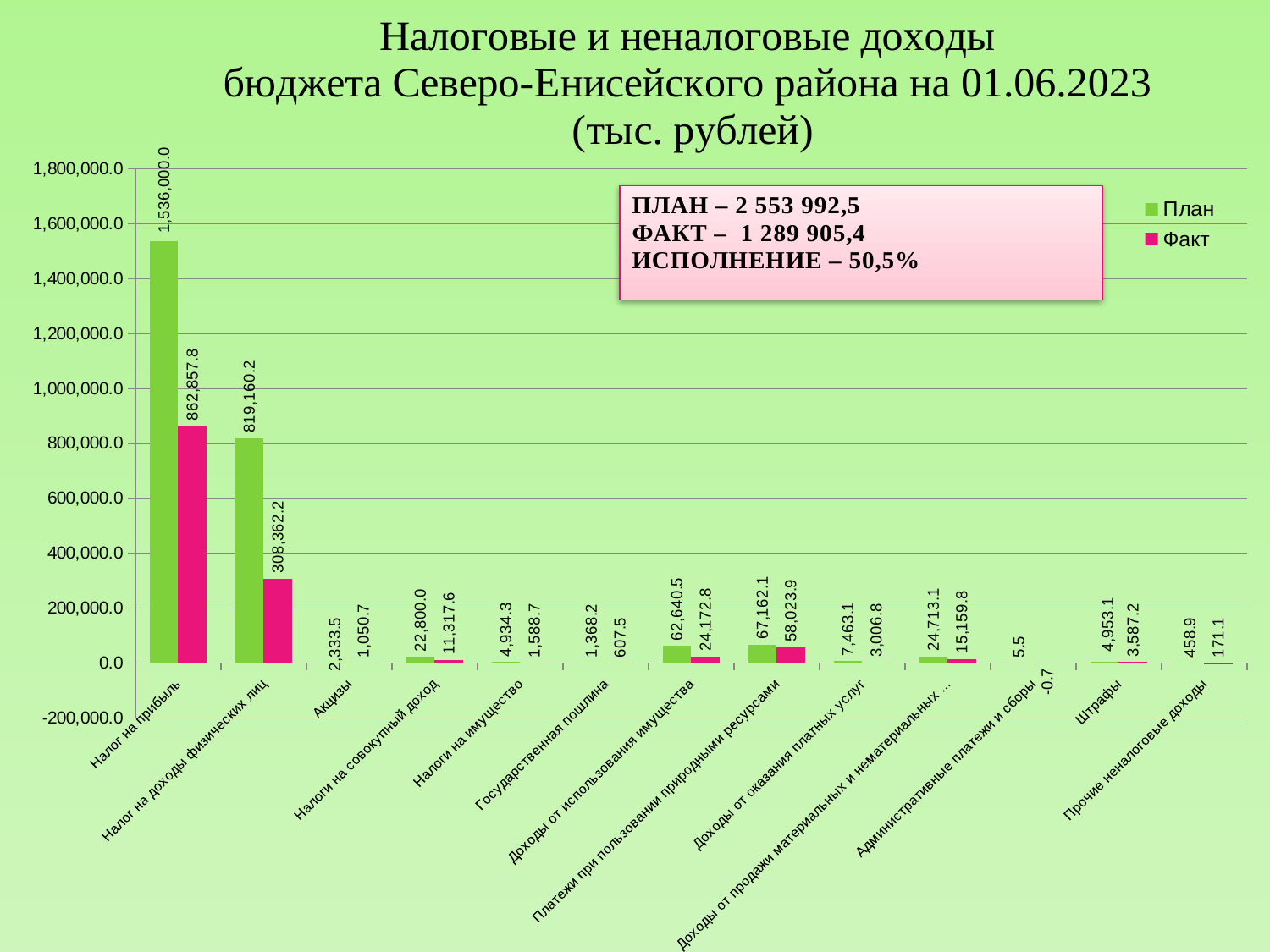
What is the Факт value for Платежи при пользовании природными ресурсами? 58,023.9 Which is larger for Доходы от использования имущества: the План value or the Факт value? План How many series does the legend list? 2 Which category has the lowest Факт value? Административные платежи и сборы What is the difference between the План and Факт values for Налог на прибыль? 673,142.2 What kind of chart is shown on the slide? Bar chart Which category has the highest План value? Налог на прибыль What is the Факт value for Административные платежи и сборы? -0.7 What is the План value for Налог на прибыль? 1,536,000.0 How many categories are shown on the x axis? 13 What is the Факт value for Налог на доходы физических лиц? 308,362.2 What is the План value for Штрафы? 4,953.1